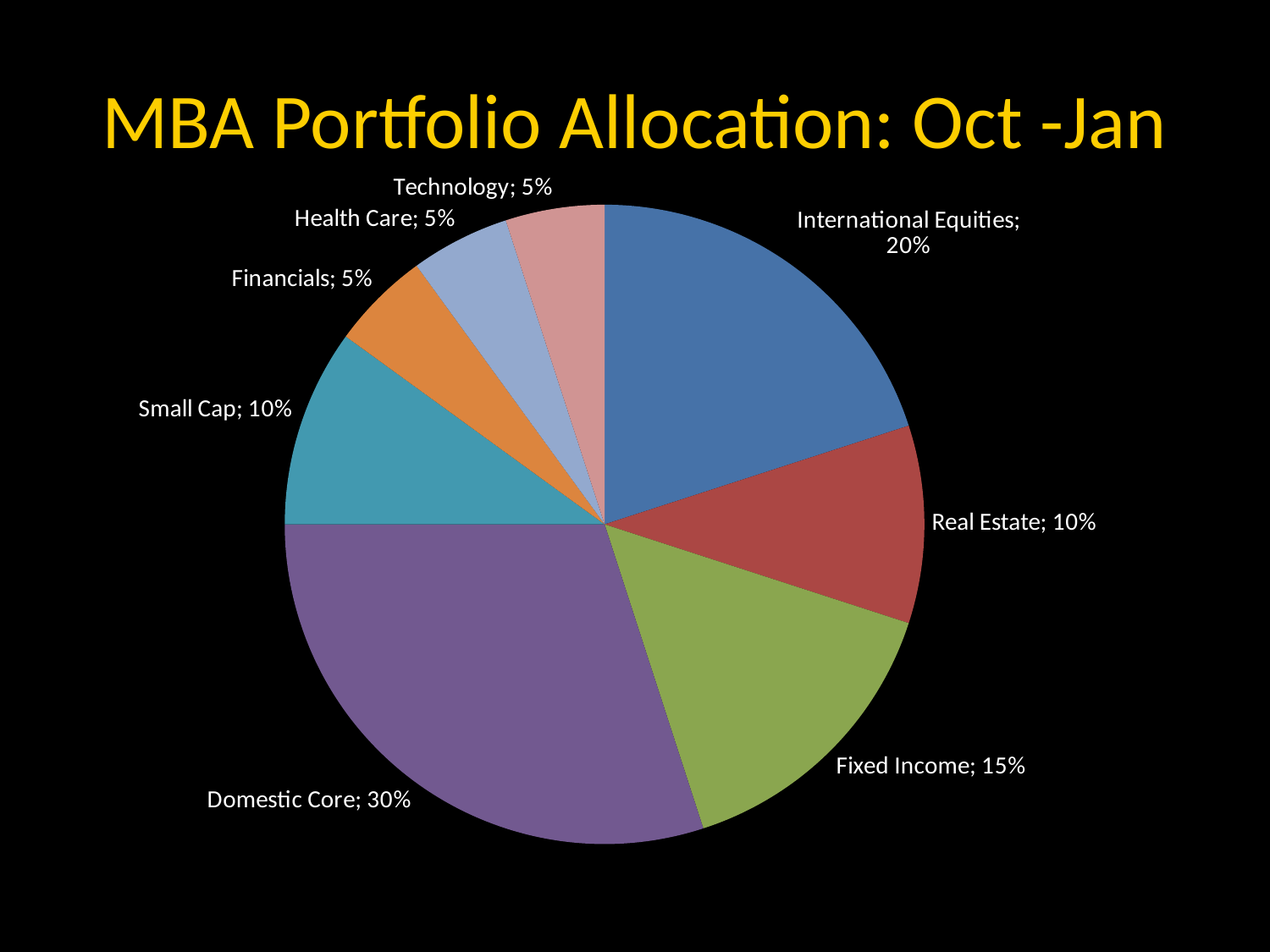
What share of the portfolio is allocated to Small Cap? 10% What kind of chart is shown on the slide? pie chart How many categories are shown in the pie chart? 8 What is the title of the chart? MBA Portfolio Allocation: Oct -Jan What share of the portfolio is allocated to Fixed Income? 15% Which is larger, the share for Fixed Income or the share for Real Estate? Fixed Income What share of the portfolio is allocated to Domestic Core? 30% Which category has the largest share of the portfolio? Domestic Core What is the difference between the Domestic Core share and the International Equities share? 10% What share of the portfolio is allocated to International Equities? 20% How many categories each have a 5% share? 3 What is the combined share of Real Estate and Small Cap? 20%